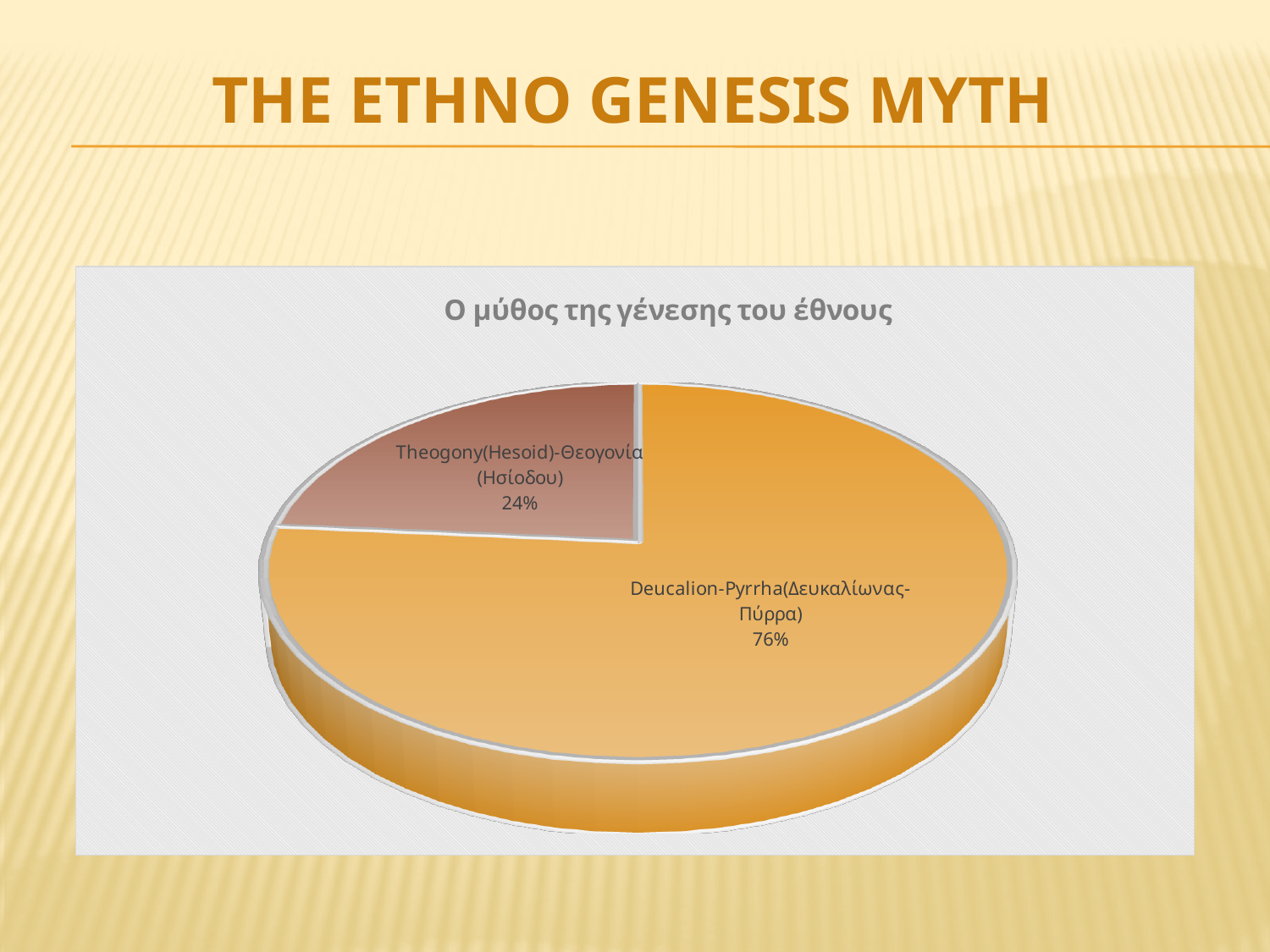
Is the share for Theogony (Hesoid) greater or less than 50%? less What kind of chart is shown on the slide? pie chart Which slice is the largest? Deucalion-Pyrrha (Δευκαλίωνας-Πύρρα) What colour is the Deucalion-Pyrrha slice? orange What share of the pie does Theogony (Hesoid) - Θεογονία (Ησίοδου) have? 24% What share of the pie does Deucalion-Pyrrha (Δευκαλίωνας-Πύρρα) have? 76% Which slice is the smallest? Theogony (Hesoid) - Θεογονία (Ησίοδου) What is the chart's title? Ο μύθος της γένεσης του έθνους What is the difference in percentage points between the Deucalion-Pyrrha slice and the Theogony (Hesoid) slice? 52 percentage points How many slices does the pie chart have? 2 Which is larger, the Theogony (Hesoid) slice or the Deucalion-Pyrrha slice? Deucalion-Pyrrha